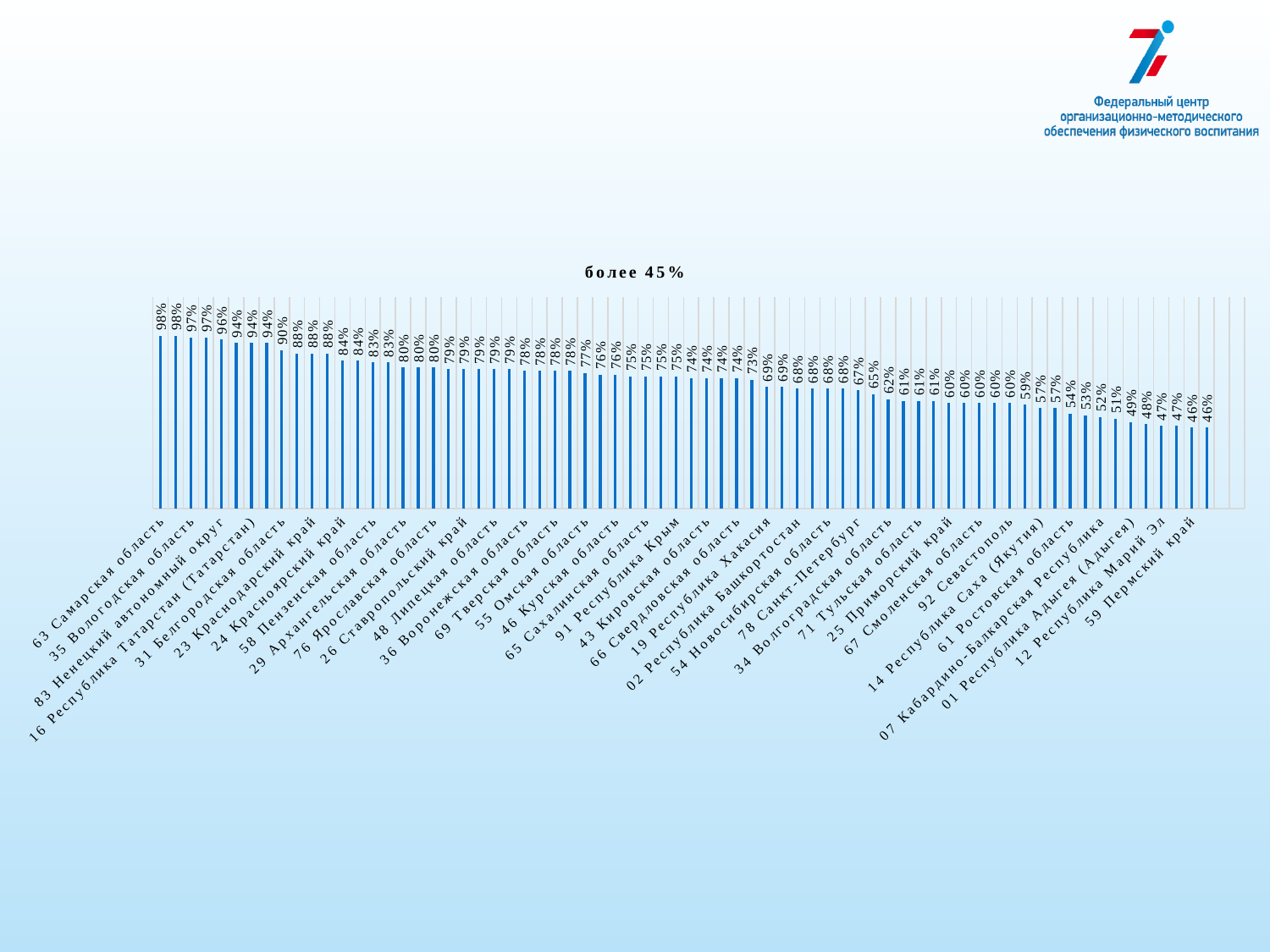
What is the value shown for 59 Пермский край? 46% What is the value shown for 63 Самарская область? 98% Is the value for 63 Самарская область greater or less than 90%? greater What is the lowest value shown on the chart? 46% Do the values rise or fall from left to right along the x axis? fall What is the highest value shown on the chart? 98% What is the difference between the values for 63 Самарская область and 59 Пермский край? 52 percentage points Is the value for 59 Пермский край greater or less than 50%? less What kind of chart is shown on the slide? bar chart What is the title of the chart? более 45% What colour are the bars in the chart? blue Which has the larger value, 63 Самарская область or 59 Пермский край? 63 Самарская область